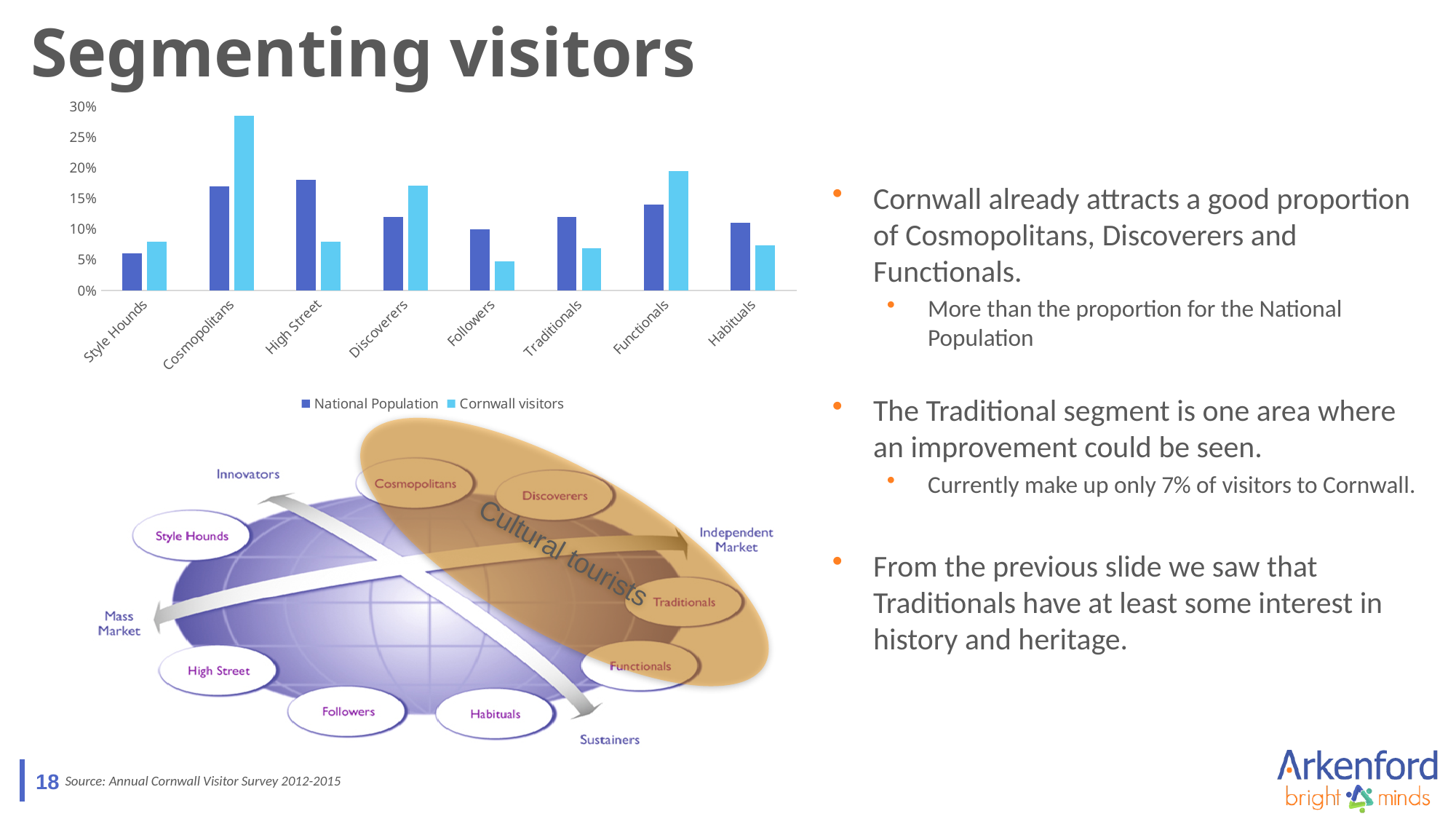
For Functionals, which is larger: the National Population value or the Cornwall visitors value? Cornwall visitors How many series does the bar chart's legend list? 2 Is the Cornwall visitors value for Traditionals greater or less than 10%? less Is the National Population value for High Street greater or less than 15%? greater For High Street, which is larger: the National Population value or the Cornwall visitors value? National Population What are the two series named in the bar chart's legend? National Population and Cornwall visitors Which segment has the lowest Cornwall visitors value in the bar chart? Followers Which segment has the highest Cornwall visitors value in the bar chart? Cosmopolitans Which segment has the lowest National Population value in the bar chart? Style Hounds What kind of chart is shown at the top left of the slide? bar chart Is the Cornwall visitors value for Cosmopolitans greater or less than 25%? greater How many visitor segments are shown on the x axis of the bar chart? 8